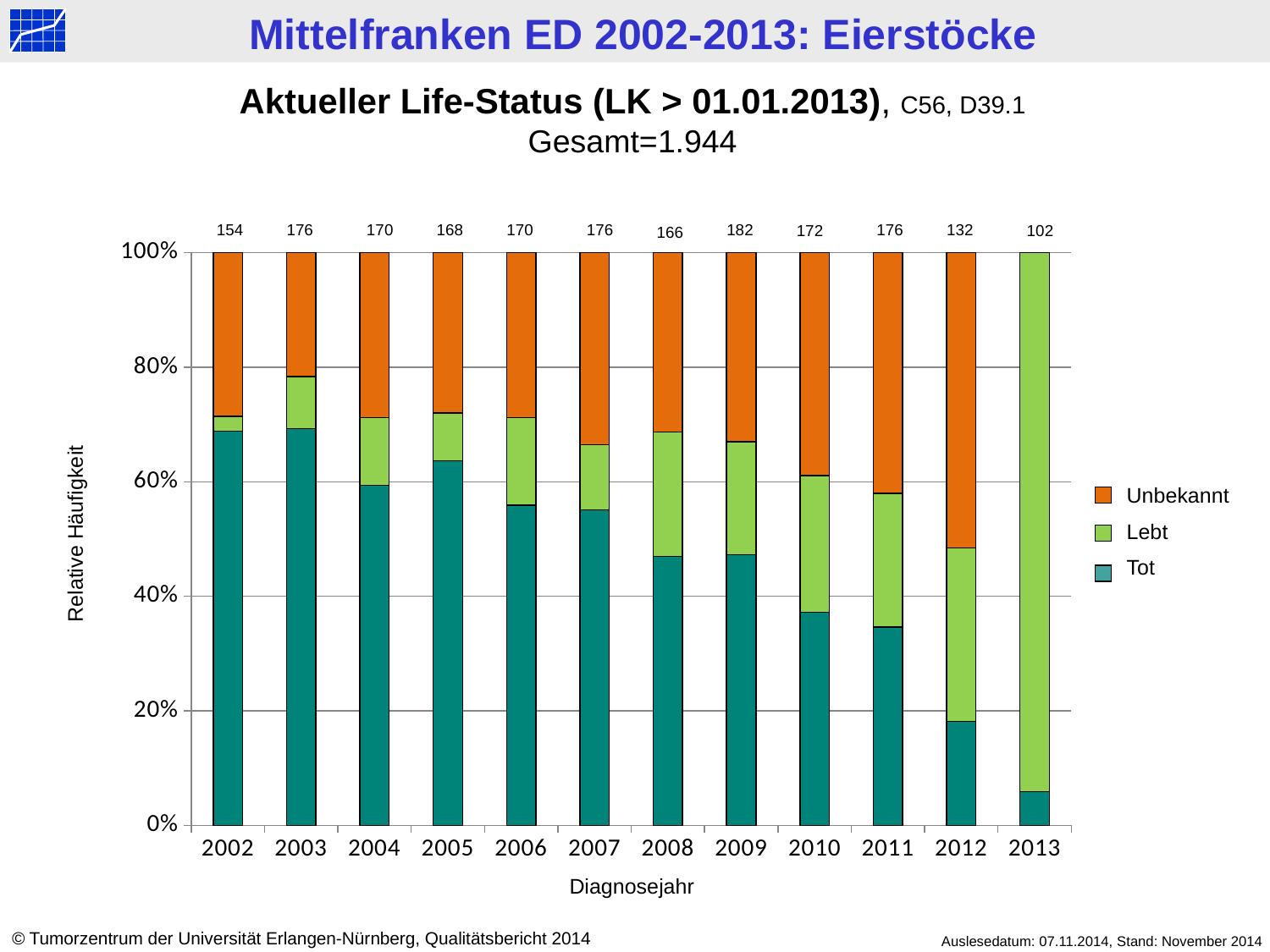
Is the share of 'Tot' in 2013 greater or less than 20%? less Which year has the highest number printed above its bar? 2009 Which year has a larger number printed above its bar, 2012 or 2013? 2012 Which year has the lowest number printed above its bar? 2013 What kind of chart is shown on the slide? Stacked bar chart What is the difference between the numbers printed above the bars for 2009 and 2013? 80 What number is printed above the bar for 2009? 182 What number is printed above the bar for 2013? 102 Is the share of 'Tot' in 2002 greater or less than 60%? greater What number is printed above the bar for 2002? 154 How many years are shown on the x axis? 12 How many series does the legend list? 3